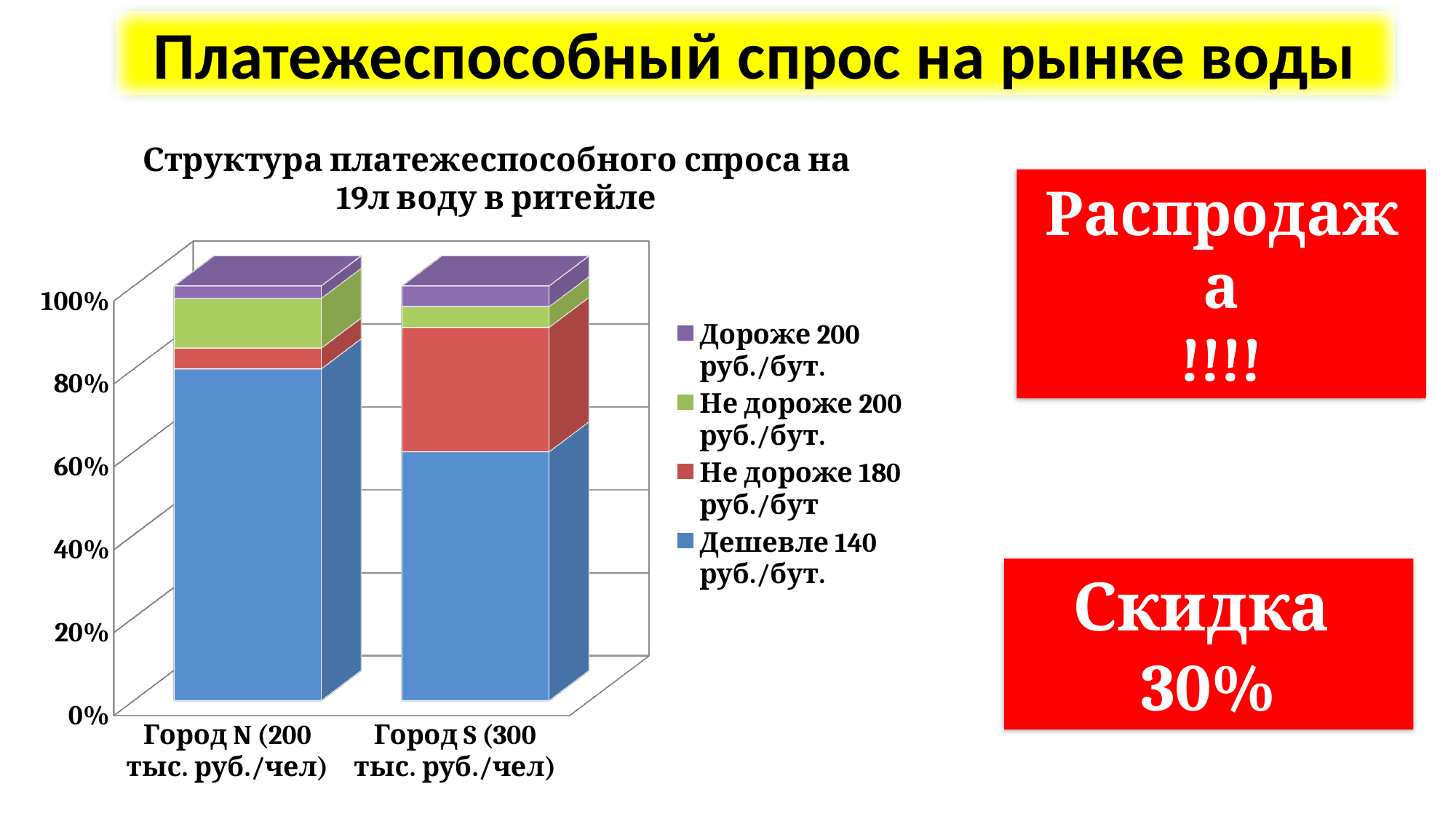
Which series has the largest share in the bar for Город S (300 тыс. руб./чел)? Дешевле 140 руб./бут. Which series has the largest share in the bar for Город N (200 тыс. руб./чел)? Дешевле 140 руб./бут. Which city has the larger share of 'Дешевле 140 руб./бут.', Город N (200 тыс. руб./чел) or Город S (300 тыс. руб./чел)? Город N (200 тыс. руб./чел) Is the share of 'Дешевле 140 руб./бут.' for Город S (300 тыс. руб./чел) greater or less than 80%? less Is the share of 'Дешевле 140 руб./бут.' for Город N (200 тыс. руб./чел) greater or less than 60%? greater Which legend entry is shown in blue? Дешевле 140 руб./бут. What kind of chart is shown on the slide? Stacked bar chart How many categories (cities) are shown on the x axis of the chart? 2 Which city has the larger share of 'Не дороже 180 руб./бут', Город N (200 тыс. руб./чел) or Город S (300 тыс. руб./чел)? Город S (300 тыс. руб./чел) What is the title of the chart? Структура платежеспособного спроса на 19л воду в ритейле How many series does the chart's legend list? 4 Which city has the larger share of 'Не дороже 200 руб./бут.', Город N (200 тыс. руб./чел) or Город S (300 тыс. руб./чел)? Город N (200 тыс. руб./чел)